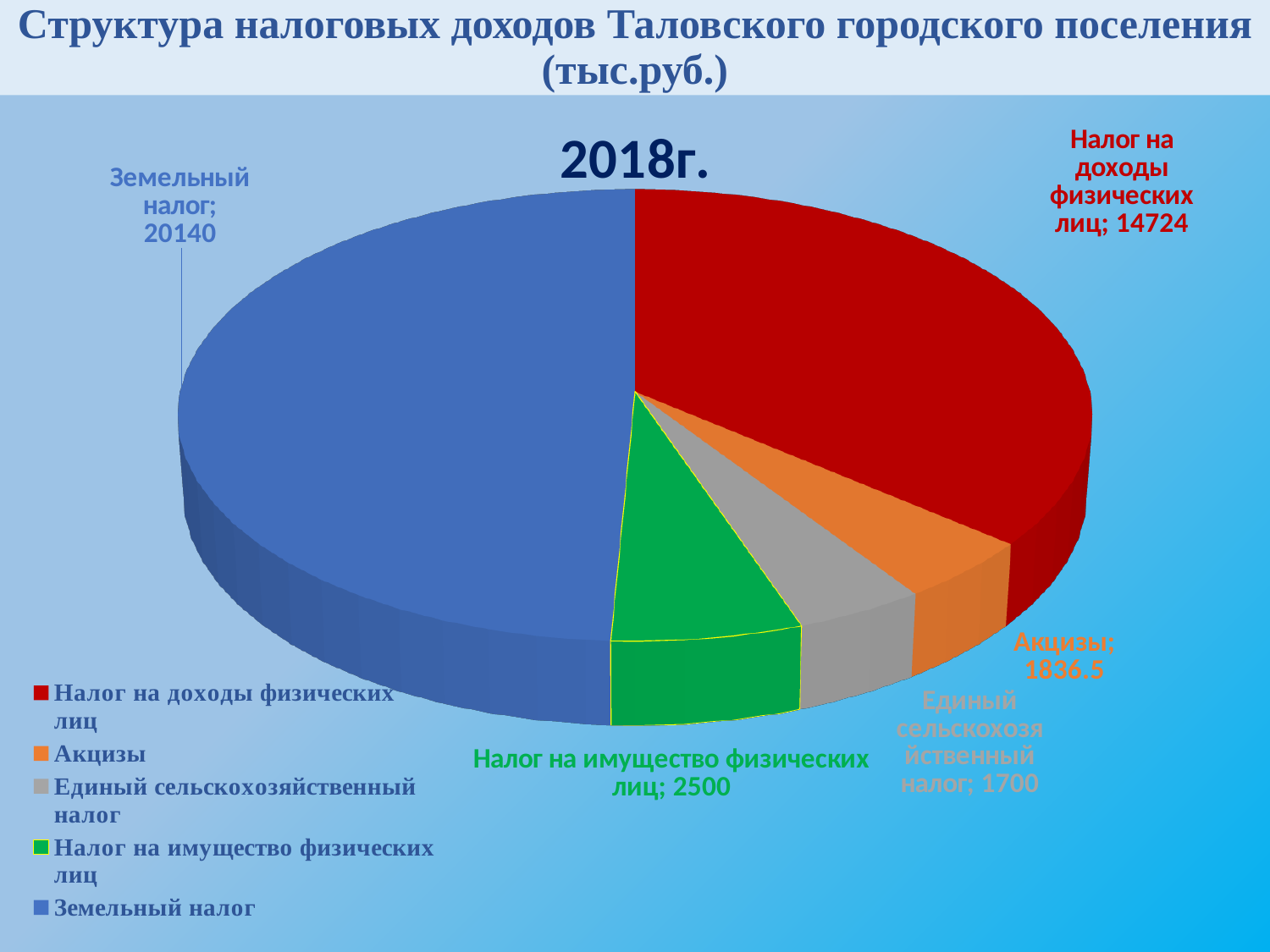
What is the value for Земельный налог in the 2018г. pie chart? 20140 What is the value for Налог на доходы физических лиц? 14724 What is the difference between Земельный налог and Налог на доходы физических лиц? 5416 What type of chart is shown on the slide? Pie chart What is the value for Акцизы? 1836.5 Which category has the largest slice of the pie? Земельный налог How many categories are shown in the pie chart? 5 What year is shown in the chart title? 2018г. What is the value for Налог на имущество физических лиц? 2500 What is the value for Единый сельскохозяйственный налог? 1700 Which is larger: Налог на имущество физических лиц or Акцизы? Налог на имущество физических лиц Which category has the smallest slice of the pie? Единый сельскохозяйственный налог